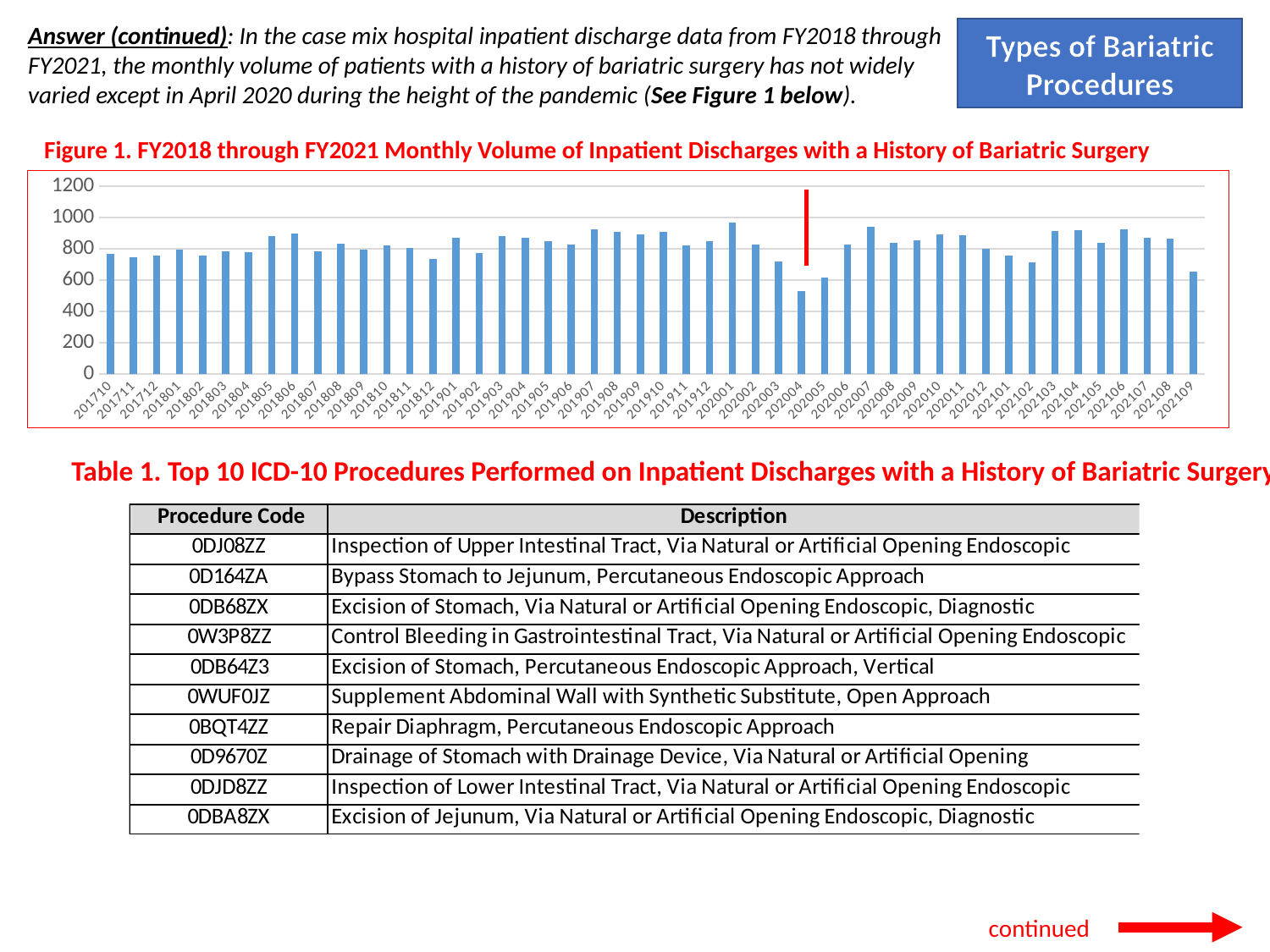
Is the value for 202004 greater or less than 600? less Which month has the lowest volume in Figure 1? 202004 Is the value for 202003 greater or less than 800? less Which is larger, the value for 202001 or the value for 202004? 202001 What is the first month shown on the x axis of Figure 1? 201710 Is the value for 202001 greater or less than 800? greater How many monthly bars are plotted in Figure 1? 48 Which is larger, the value for 201710 or the value for 201806? 201806 What kind of chart is Figure 1? bar chart What is the highest value shown on the y axis of Figure 1? 1200